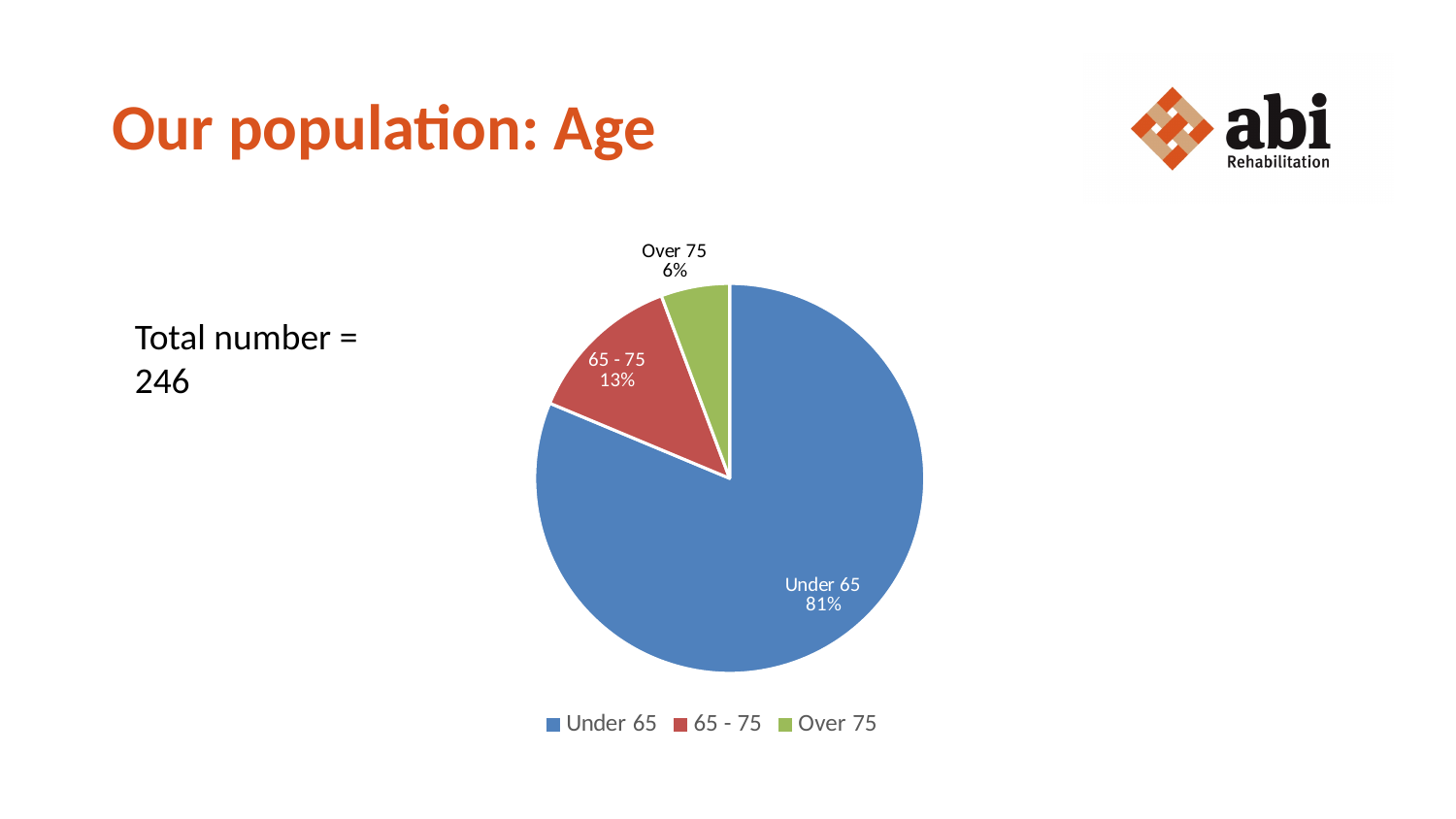
What colour is the Under 65 slice? blue What is the total number of people stated on the slide? 246 Which slice is larger, 65 - 75 or Over 75? 65 - 75 What kind of chart is shown on the slide? pie chart Which age group has the smallest share of the pie? Over 75 What is the difference in percentage points between the Under 65 and 65 - 75 slices? 68 What is the difference in percentage points between the 65 - 75 and Over 75 slices? 7 What share of the population is Over 75? 6% What share of the population is Under 65? 81% What share of the population is aged 65 - 75? 13% How many age groups are shown in the pie chart? 3 Which age group has the largest share of the pie? Under 65